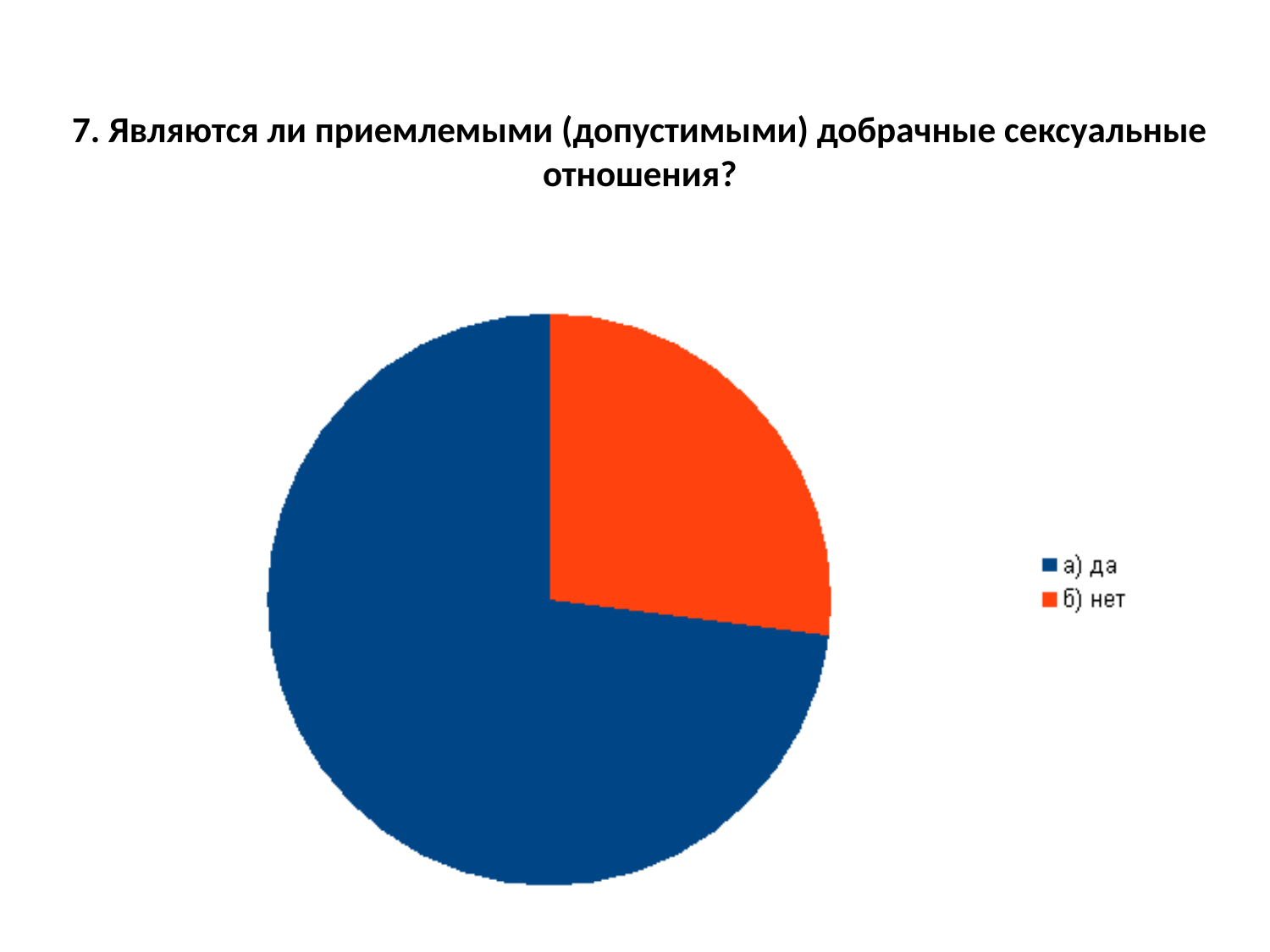
Which slice is larger in the pie chart, "а) да" or "б) нет"? а) да Which category has the largest slice in the pie chart? а) да What colour is the "б) нет" slice in the pie chart? Orange How many slices does the pie chart have? 2 What is the title of the slide above the pie chart? 7. Являются ли приемлемыми (допустимыми) добрачные сексуальные отношения? How many entries does the legend of the pie chart list? 2 Does the "а) да" slice take up more or less than half of the pie? more Which category has the smallest slice in the pie chart? б) нет What kind of chart is shown on the slide? Pie chart